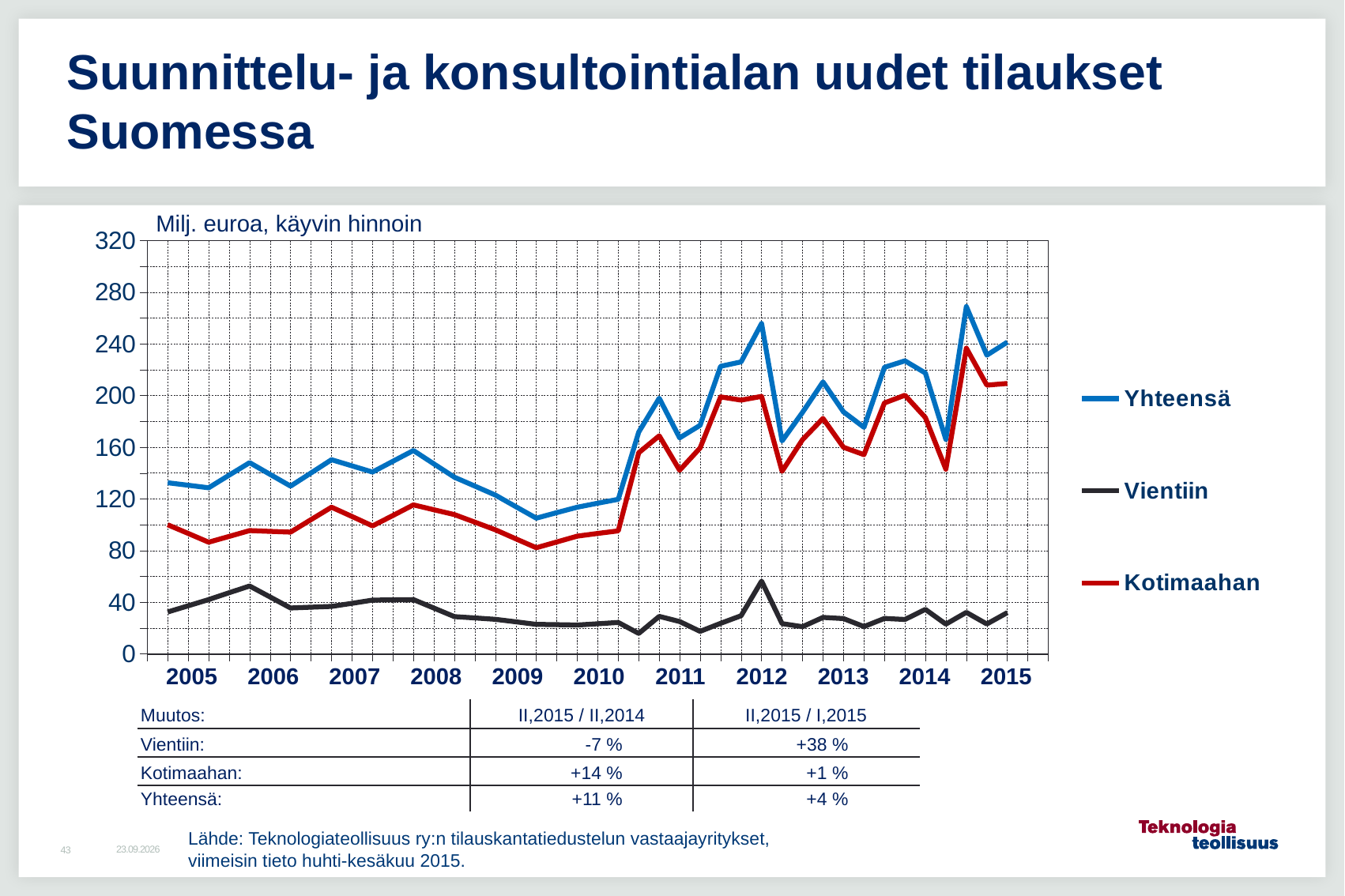
What kind of chart is shown on the slide? line chart Is the peak value for Vientiin in 2012 greater or less than 40? greater Does the Vientiin series rise or fall between 2006 and 2009? fall Is the value for Kotimaahan in 2009 greater or less than 120? less Is the highest value for Yhteensä, reached in 2014, greater or less than 240? greater How many series does the legend list? 3 How many year labels are shown on the x axis? 11 Which series has the lowest values throughout the chart? Vientiin What unit label is shown above the chart's y axis? Milj. euroa, käyvin hinnoin Which series has the highest values throughout the chart? Yhteensä What are the three series named in the legend? Yhteensä, Vientiin, Kotimaahan